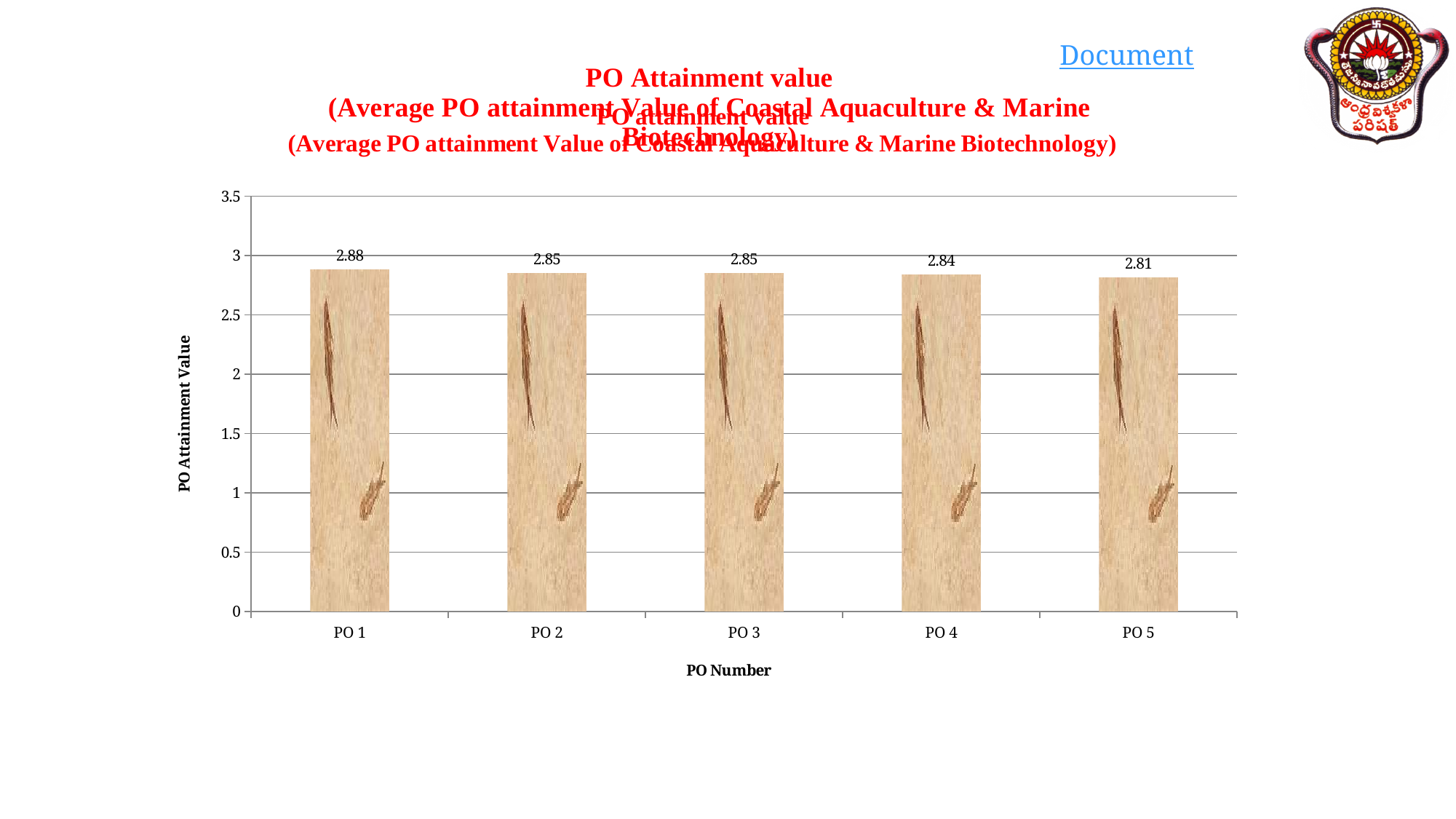
What is the label of the vertical axis? PO Attainment Value What kind of chart is shown on the slide? bar chart What is the difference between the attainment values of PO 1 and PO 5? 0.07 What is the PO attainment value for PO 5? 2.81 What is the difference between the attainment values of PO 2 and PO 4? 0.01 What is the PO attainment value for PO 1? 2.88 Which has a larger attainment value, PO 1 or PO 4? PO 1 Which PO has the lowest attainment value? PO 5 What is the PO attainment value for PO 4? 2.84 How many PO categories are shown on the x axis? 5 Is the value for PO 3 greater or less than 3? less Which PO has the highest attainment value? PO 1